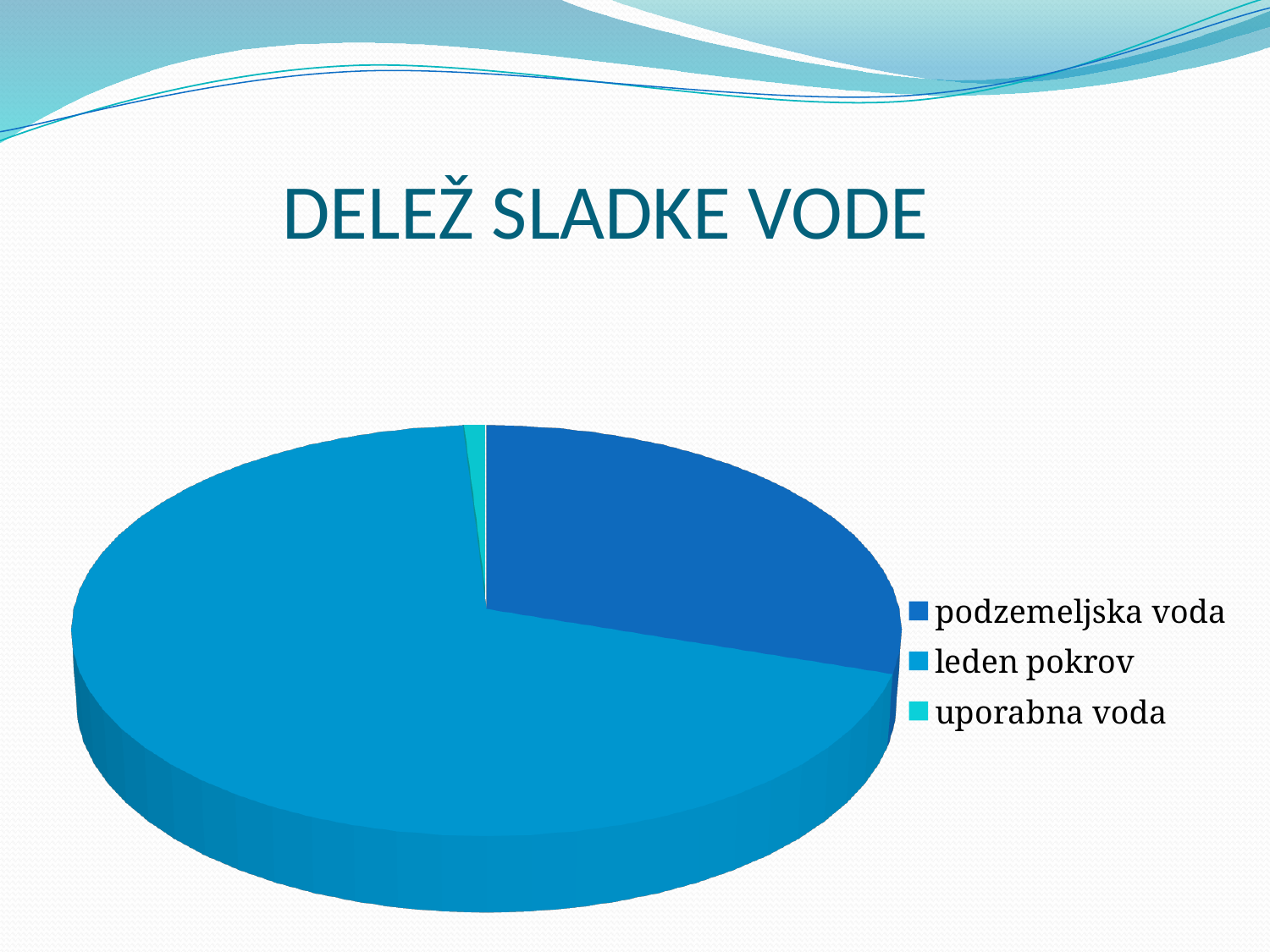
Which slice is larger, leden pokrov or podzemeljska voda? leden pokrov How many entries does the legend of the pie chart list? 3 Which category has the smallest slice of the pie chart? uporabna voda How many slices does the pie chart have? 3 What kind of chart is shown on the slide? pie chart What is the title of the slide containing the pie chart? DELEŽ SLADKE VODE Which category has the largest slice of the pie chart? leden pokrov Which slice is smaller, uporabna voda or leden pokrov? uporabna voda Which slice is larger, podzemeljska voda or uporabna voda? podzemeljska voda Which legend entry is listed first in the pie chart's legend? podzemeljska voda